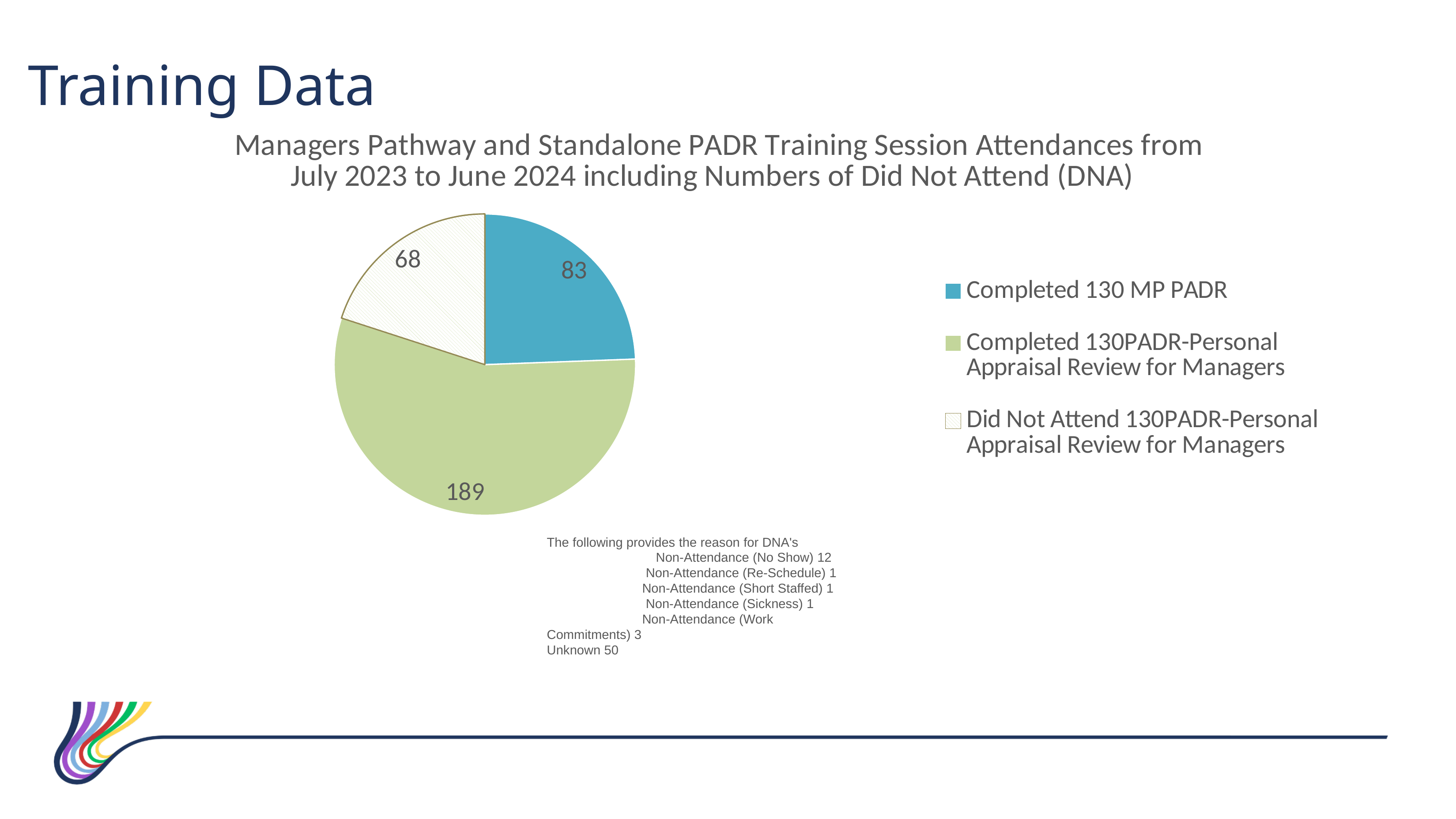
What kind of chart is shown on the slide? Pie chart What is the difference between the Completed 130 MP PADR value and the Did Not Attend 130PADR-Personal Appraisal Review for Managers value? 15 What is the value for Did Not Attend 130PADR-Personal Appraisal Review for Managers? 68 Which category has the largest slice of the pie? Completed 130PADR-Personal Appraisal Review for Managers What is the total of all three slices in the pie chart? 340 What share of the pie does the Did Not Attend 130PADR-Personal Appraisal Review for Managers slice represent? 20% What is the value for Completed 130PADR-Personal Appraisal Review for Managers? 189 How many slices does the pie chart have? 3 Which is larger: Completed 130 MP PADR or Did Not Attend 130PADR-Personal Appraisal Review for Managers? Completed 130 MP PADR Which category has the smallest slice of the pie? Did Not Attend 130PADR-Personal Appraisal Review for Managers What is the difference between the Completed 130PADR-Personal Appraisal Review for Managers value and the Completed 130 MP PADR value? 106 What is the value for Completed 130 MP PADR? 83